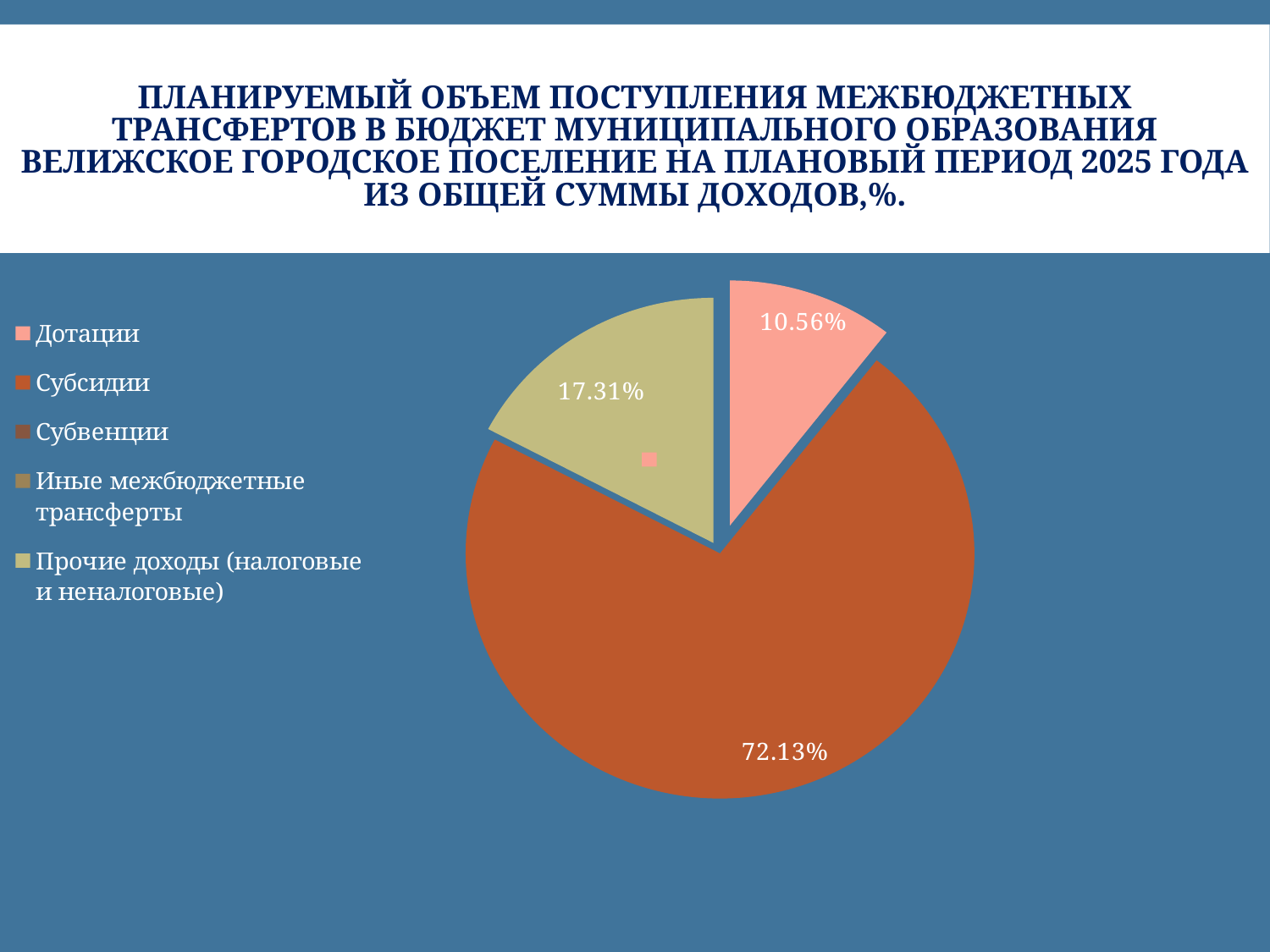
Which category has the largest slice of the pie? Субсидии What type of chart is shown on the slide? Pie chart What is the difference in percentage points between Субсидии and Дотации? 61.57% What percentage is shown for Дотации? 10.56% Which labeled slice of the pie is the smallest? Дотации How many slices of the pie have a percentage label? 3 What colour is the legend marker for Дотации? Pink Is the share for Субсидии greater or less than 50%? greater Which is larger, the share for Дотации or the share for Субсидии? Субсидии How many entries does the legend list? 5 What percentage is shown for Субсидии? 72.13% What is the difference between the largest slice and the second-largest slice? 54.82%